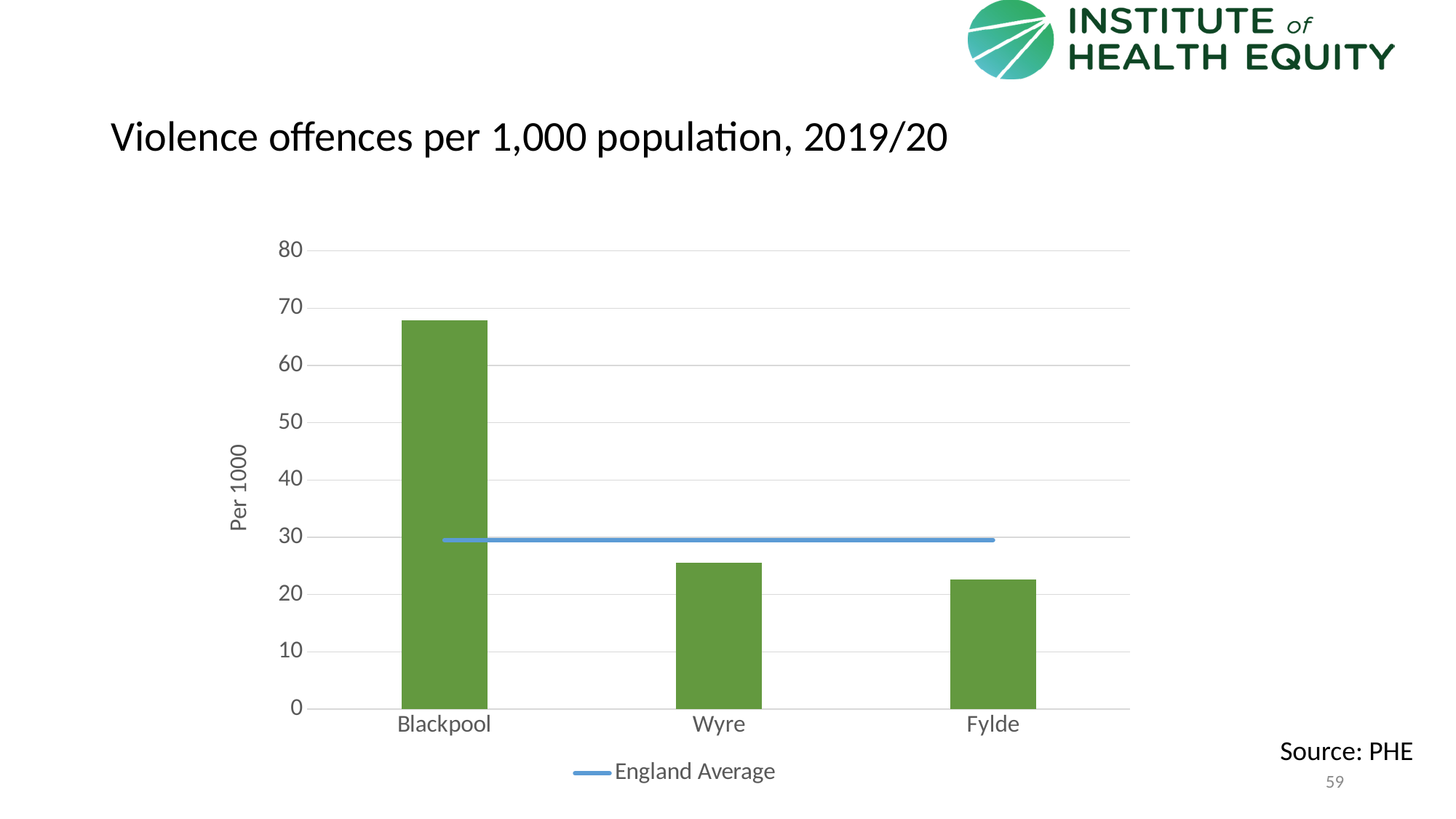
Do the bar values rise or fall from left to right across the x axis? fall Which area has the highest rate of violence offences per 1,000 population? Blackpool Is the England Average line above or below 40? below Which area has the lowest rate of violence offences per 1,000 population? Fylde What kind of chart is shown on the slide? bar and line chart Is the value for Fylde greater or less than 30? less What entry does the legend list? England Average Which has a higher value, Blackpool or Wyre? Blackpool Is the value for Blackpool greater or less than 60? greater How many areas are shown on the x axis of the chart? 3 What is the label on the y axis? Per 1000